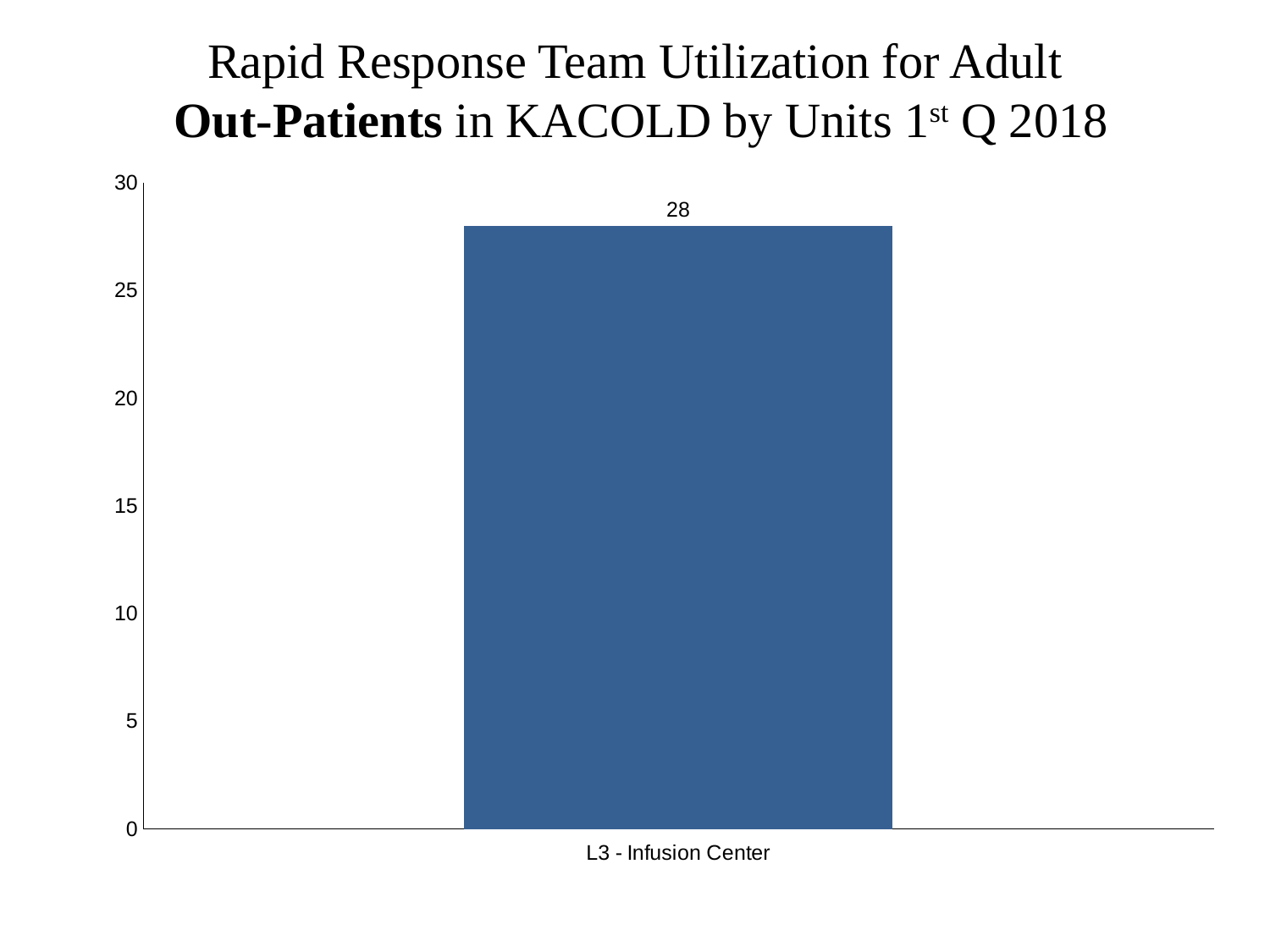
How many categories are plotted on the chart? 1 Is the value for L3 - Infusion Center greater or less than 25? greater What kind of chart is shown on the slide? bar chart Is the value for L3 - Infusion Center greater or less than 30? less What is the label of the only category on the x axis? L3 - Infusion Center What is the value for L3 - Infusion Center? 28 What is the maximum value shown on the y axis? 30